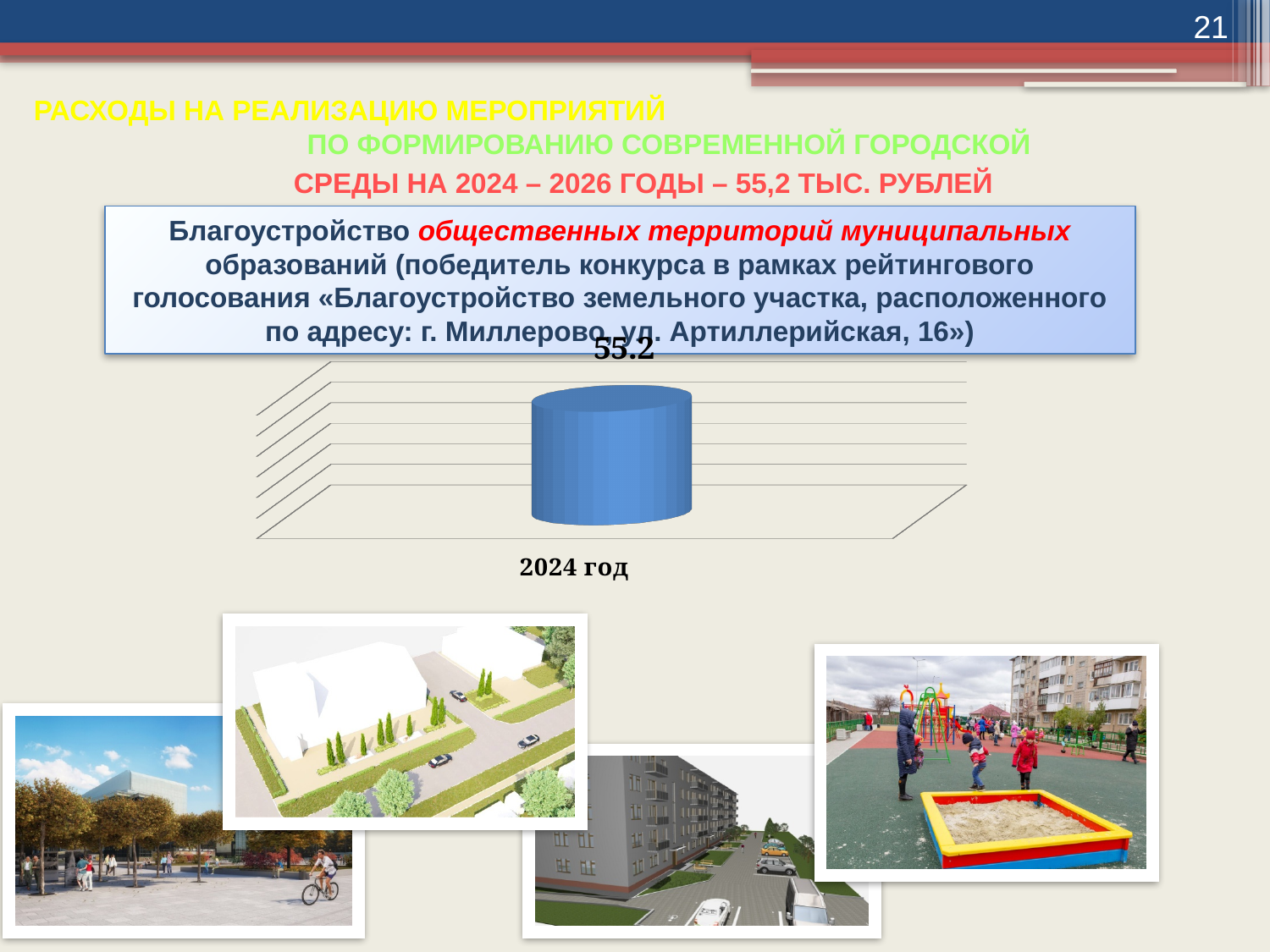
What colour is the bar on the chart? blue How many categories are plotted on the chart? 1 What data label is printed above the bar on the chart? 55.2 What kind of chart is shown on the slide? bar chart What is the value shown for 2024 год on the chart? 55.2 Which year is labelled on the x axis of the chart? 2024 год